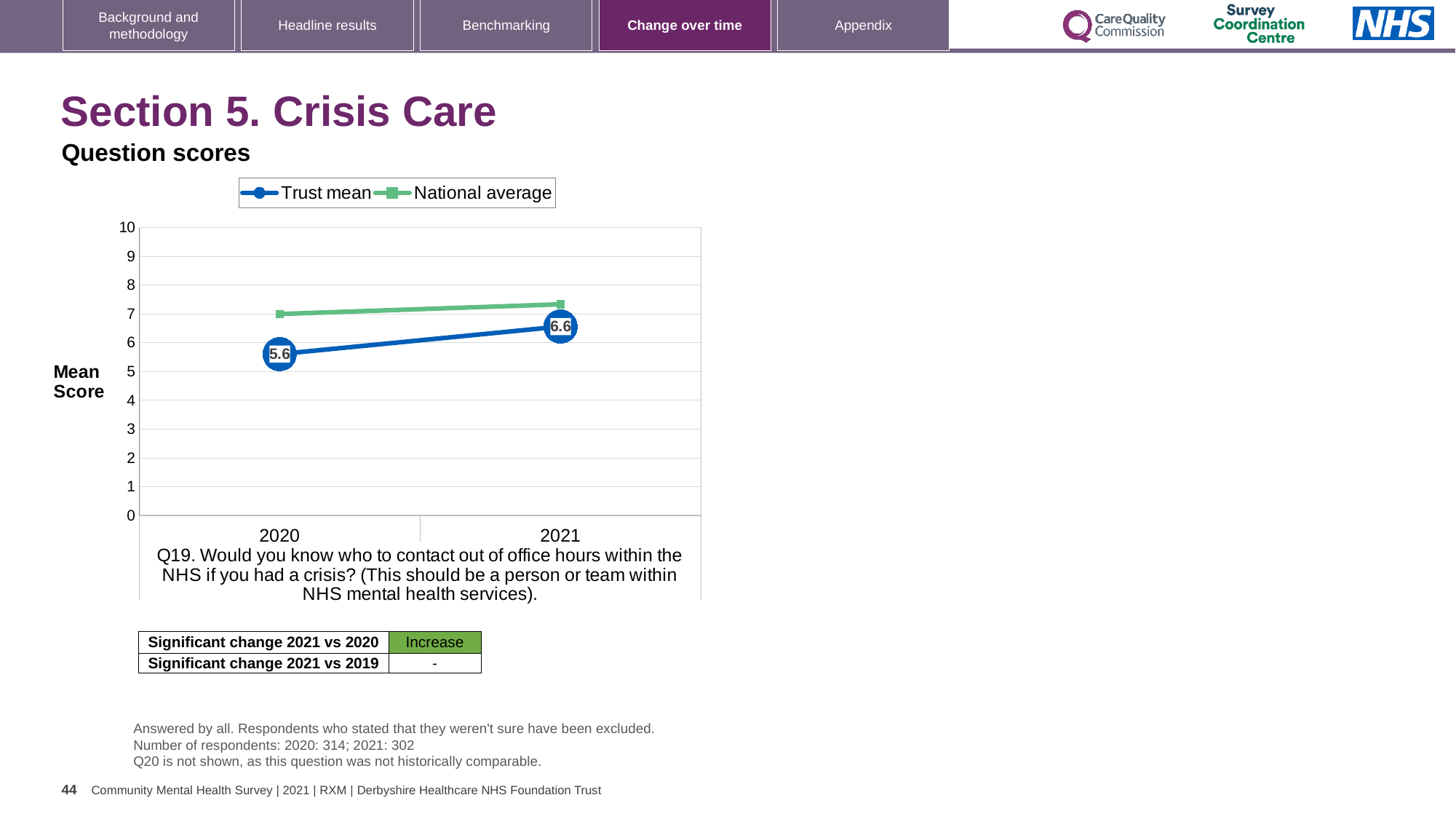
In which year is the Trust mean score highest? 2021 What is the Trust mean score for 2020? 5.6 In 2021, which is higher: the Trust mean or the National average? National average How many series does the legend list? 2 What is the Trust mean score for 2021? 6.6 In 2020, which is higher: the Trust mean or the National average? National average How many years are plotted on the chart? 2 In which year is the Trust mean score lowest? 2020 Is the National average for 2021 greater or less than 8? less What kind of chart is shown on the slide? Line chart By how much did the Trust mean score change from 2020 to 2021? 1.0 Is the National average for 2020 greater or less than 6? greater